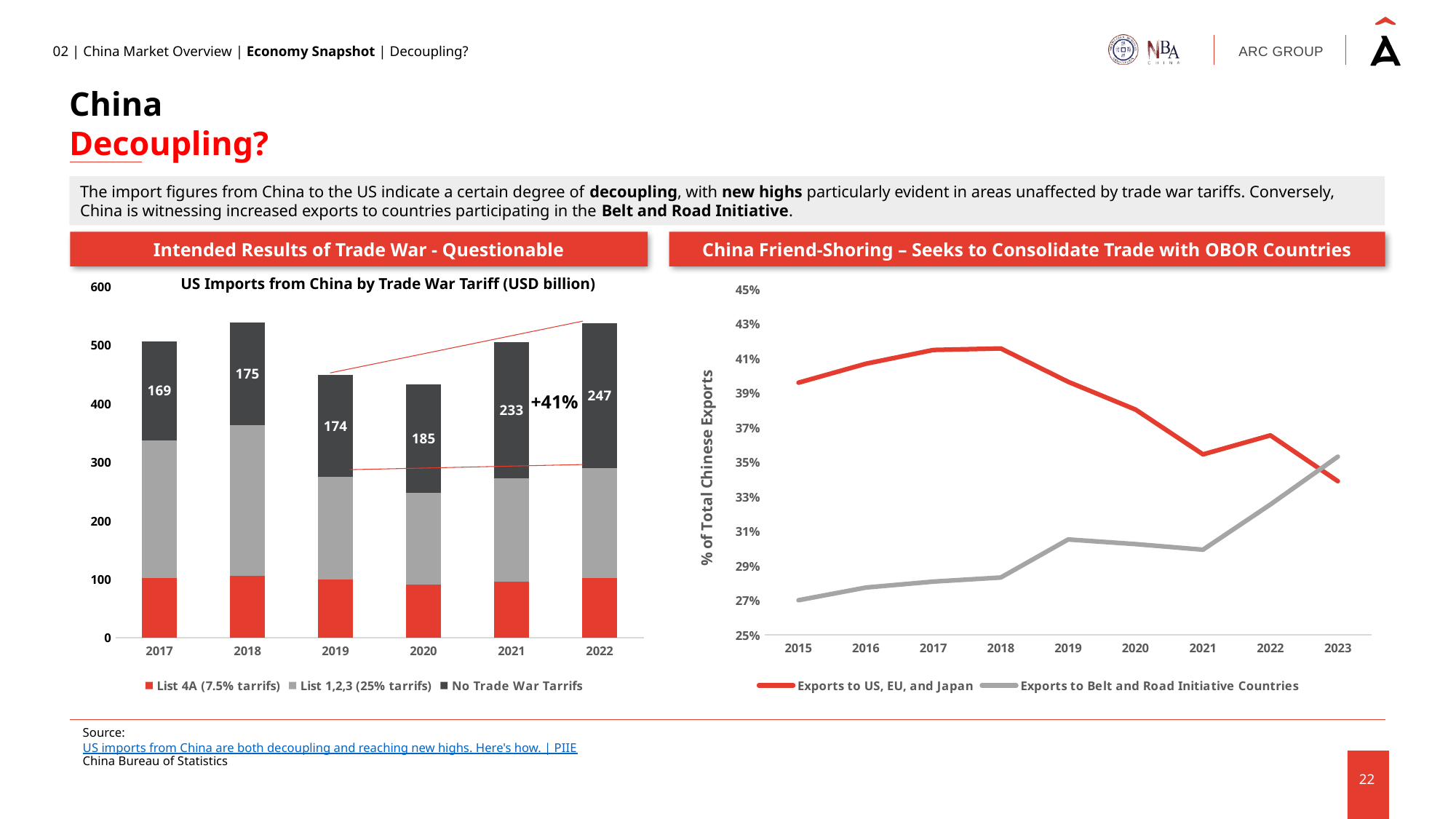
In the left chart (US Imports from China by Trade War Tariff), what is the difference between the No Trade War Tarrifs values for 2022 and 2021? 14 How many years are shown on the x axis of the left chart (US Imports from China by Trade War Tariff)? 6 What kind of chart is the right chart (% of Total Chinese Exports)? Line chart In the right chart (% of Total Chinese Exports), does the Exports to Belt and Road Initiative Countries line rise or fall from 2015 to 2023? rises In the right chart (% of Total Chinese Exports), is the value for Exports to Belt and Road Initiative Countries in 2015 greater or less than 29%? less In the left chart (US Imports from China by Trade War Tariff), what is the value of the No Trade War Tarrifs segment in 2017? 169 In the left chart (US Imports from China by Trade War Tariff), what is the value of the No Trade War Tarrifs segment in 2022? 247 What kind of chart is the left chart (US Imports from China by Trade War Tariff)? Stacked bar chart In the left chart (US Imports from China by Trade War Tariff), which year has the lowest No Trade War Tarrifs value? 2017 How many series does the legend of the right chart (% of Total Chinese Exports) list? 2 In the left chart (US Imports from China by Trade War Tariff), which year has the highest No Trade War Tarrifs value? 2022 How many series does the legend of the left chart (US Imports from China by Trade War Tariff) list? 3